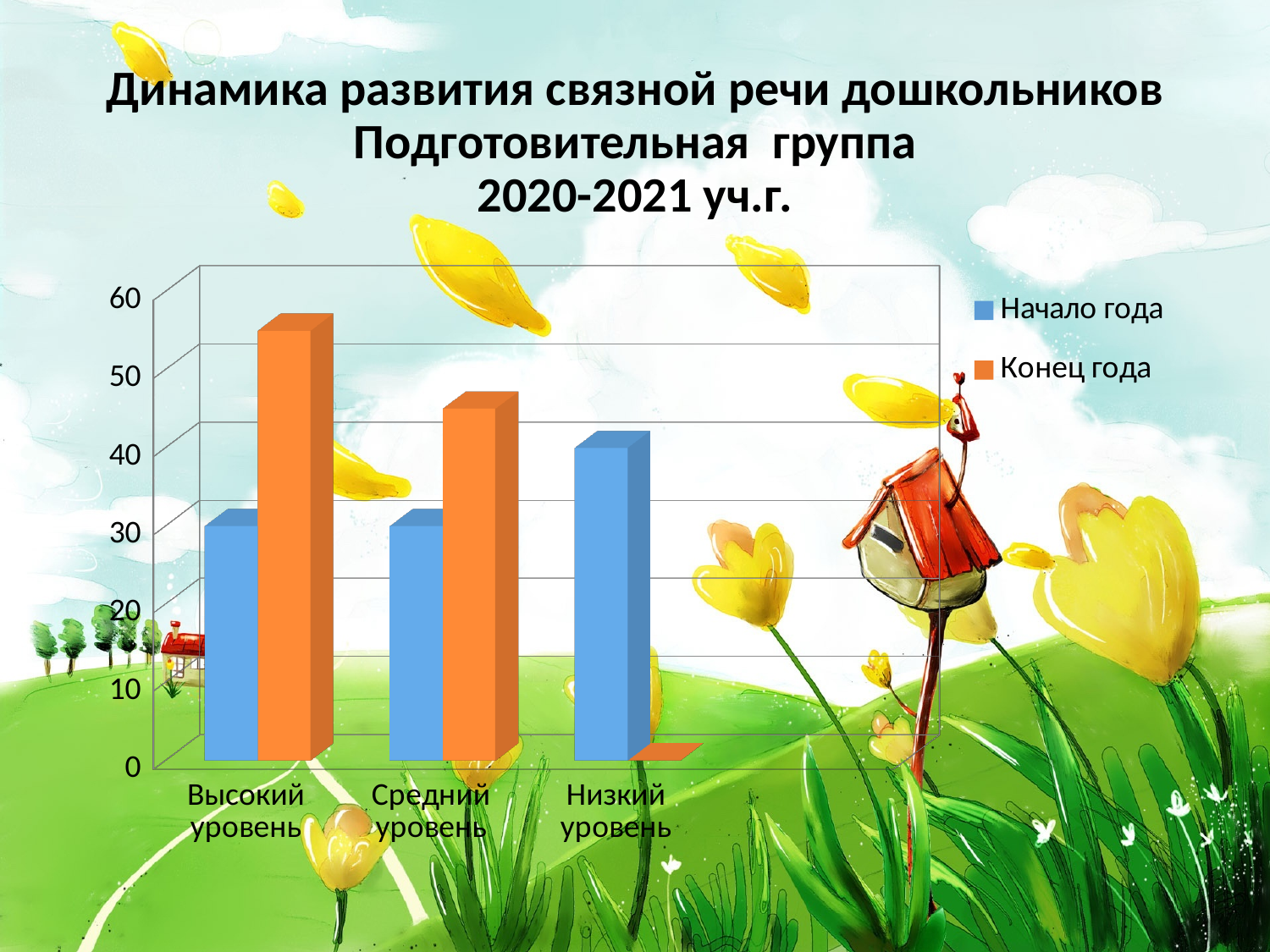
Is the value for Начало года at Низкий уровень greater or less than 50? less How many series does the legend list? 2 How many categories are shown on the x axis? 3 Which category has the highest value for Начало года? Низкий уровень For Низкий уровень, which series has the larger value, Начало года or Конец года? Начало года Is the value for Конец года at Средний уровень greater or less than 40? greater Is the value for Конец года at Высокий уровень greater or less than 50? greater For Высокий уровень, which series has the larger value, Начало года or Конец года? Конец года What are the two series named in the legend? Начало года and Конец года Which category has the lowest value for Конец года? Низкий уровень What kind of chart is shown on the slide? bar chart Which category has the highest value for Конец года? Высокий уровень